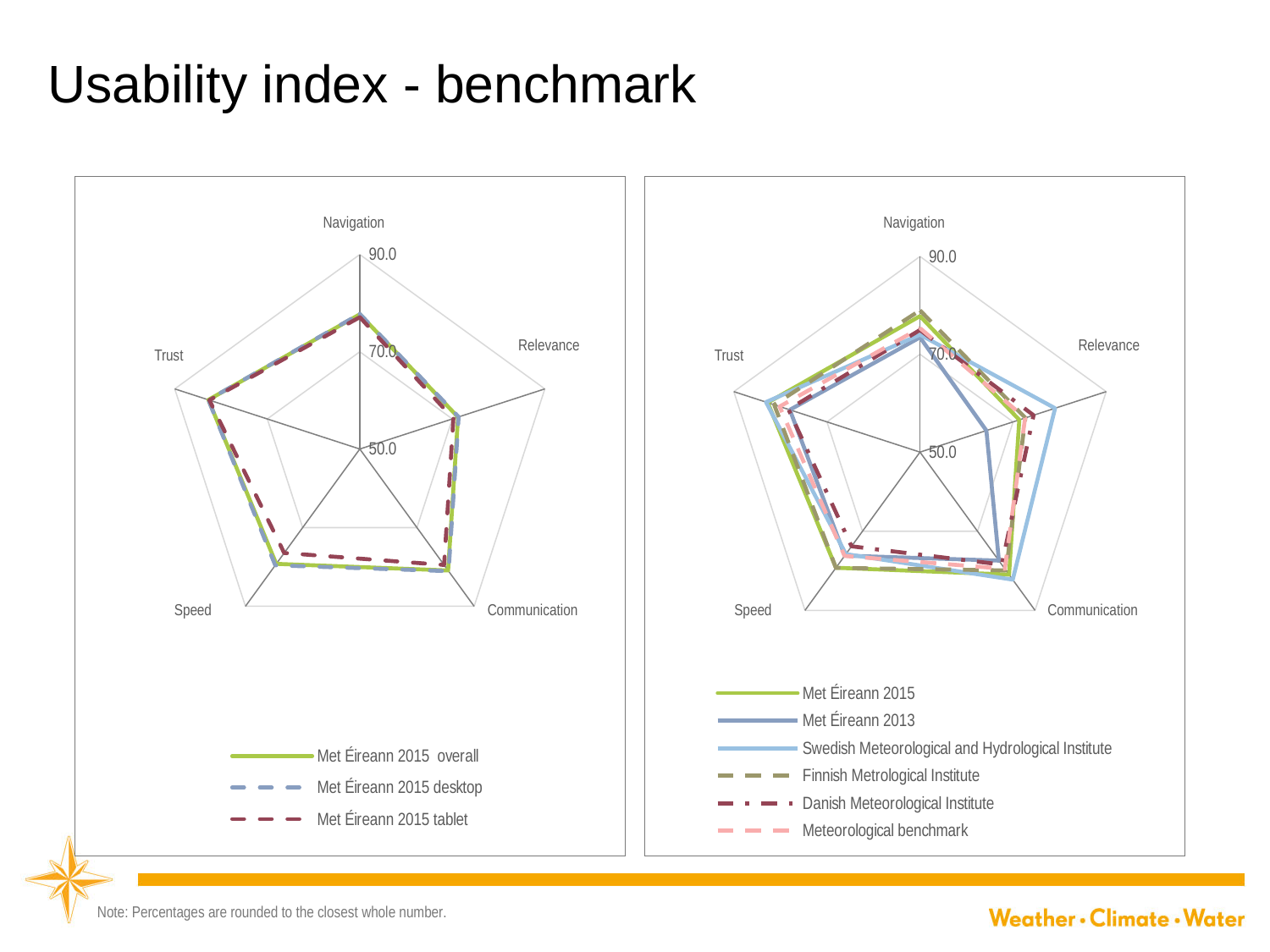
What kind of chart is the left chart on the slide? radar chart In the left chart, is the Navigation value for Met Éireann 2015 overall greater or less than 70? greater In the left chart, is the Navigation value for Met Éireann 2015 overall greater or less than 90? less In the right chart, which series is drawn with a solid light blue line according to the legend? Swedish Meteorological and Hydrological Institute How many series does the legend of the left chart list? 3 What is the title of the slide containing the two radar charts? Usability index - benchmark In the right chart, is the Trust value for the Swedish Meteorological and Hydrological Institute greater or less than 70? greater How many categories (axes) does the left radar chart have? 5 How many series does the legend of the right chart list? 6